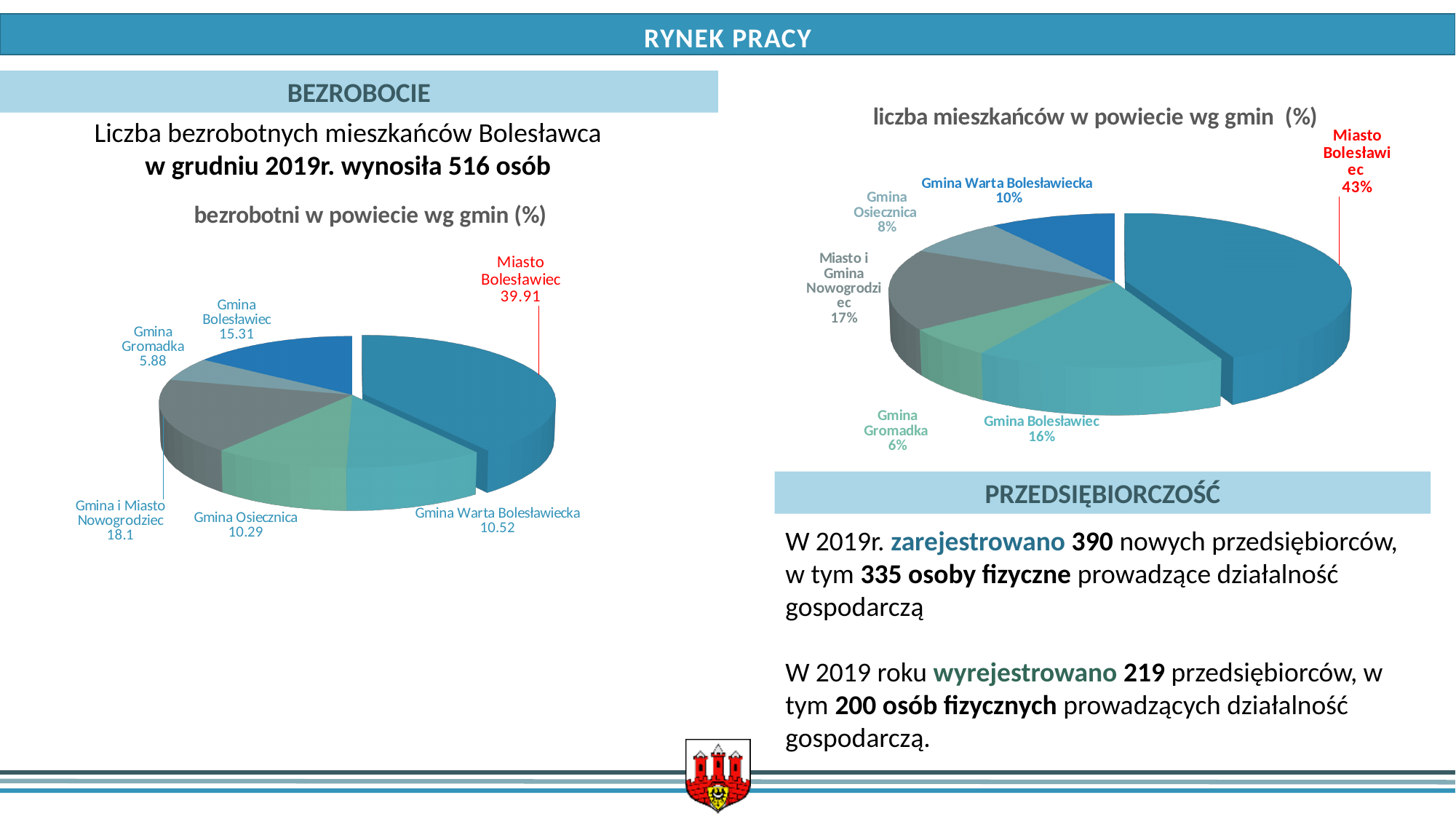
In the chart titled "bezrobotni w powiecie wg gmin (%)", how many categories are shown? 6 In the chart titled "liczba mieszkańców w powiecie wg gmin (%)", what is the difference between Miasto i Gmina Nowogrodziec and Gmina Gromadka? 11% In the chart titled "bezrobotni w powiecie wg gmin (%)", what is the difference between Gmina Bolesławiec and Gmina Osiecznica? 5.02 What kind of chart is the chart titled "bezrobotni w powiecie wg gmin (%)"? pie chart In the chart titled "liczba mieszkańców w powiecie wg gmin (%)", which category's label is shown in red? Miasto Bolesławiec In the chart titled "liczba mieszkańców w powiecie wg gmin (%)", what is the value for Miasto Bolesławiec? 43% In the chart titled "liczba mieszkańców w powiecie wg gmin (%)", which is larger: Gmina Bolesławiec or Gmina Warta Bolesławiecka? Gmina Bolesławiec In the chart titled "liczba mieszkańców w powiecie wg gmin (%)", which category has the highest value? Miasto Bolesławiec In the chart titled "liczba mieszkańców w powiecie wg gmin (%)", what is the value for Gmina Osiecznica? 8% In the chart titled "bezrobotni w powiecie wg gmin (%)", what is the value for Gmina i Miasto Nowogrodziec? 18.1 In the chart titled "bezrobotni w powiecie wg gmin (%)", which category has the lowest value? Gmina Gromadka In the chart titled "bezrobotni w powiecie wg gmin (%)", what is the value for Miasto Bolesławiec? 39.91